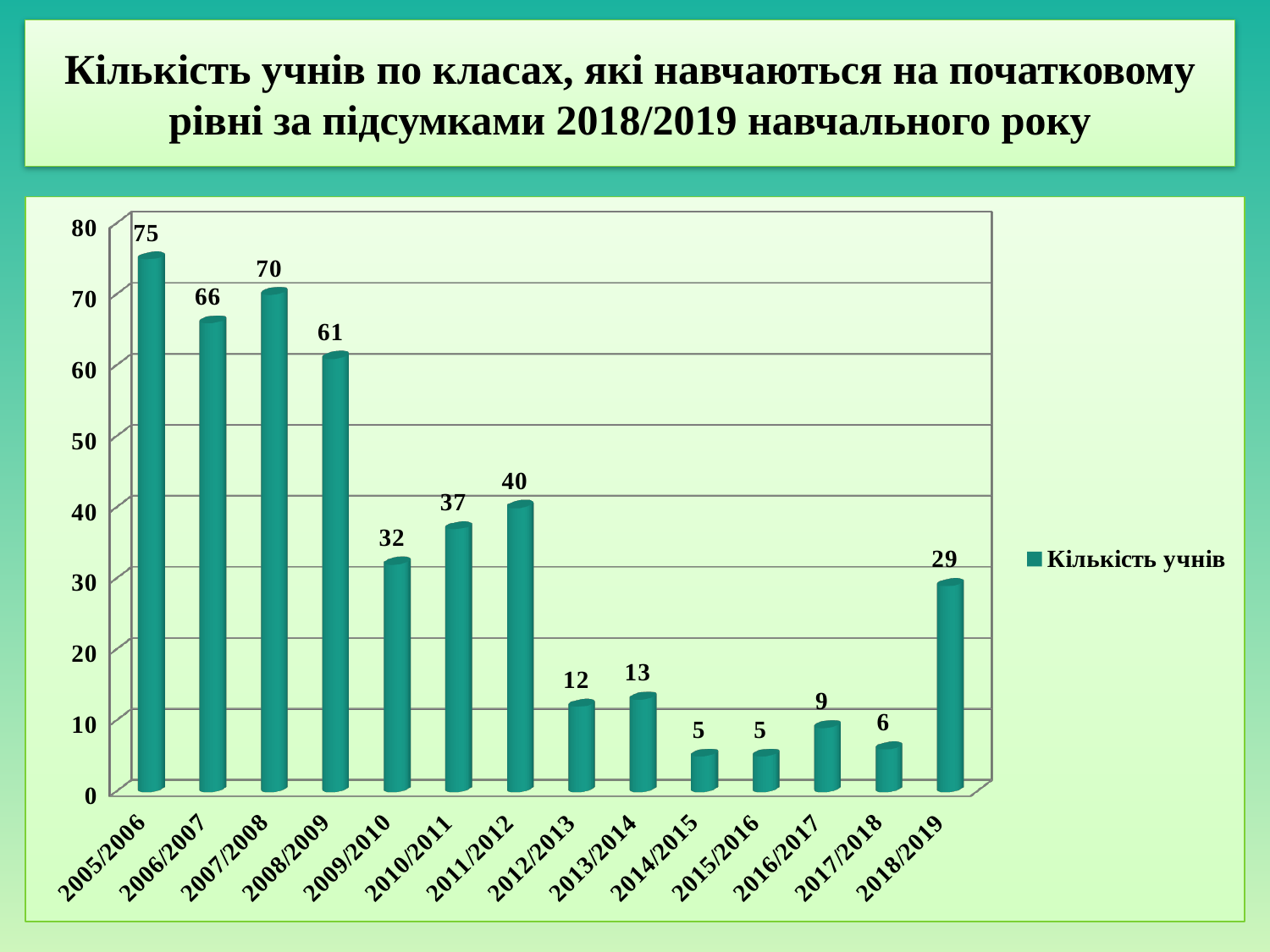
What is the value for 2011/2012? 40 What is the value for 2005/2006? 75 What is the value for 2018/2019? 29 How many series does the legend list? 1 Which is larger, the value for 2012/2013 or 2013/2014? 2013/2014 How many years are shown on the x axis? 14 Which year has the highest value? 2005/2006 What kind of chart is shown? bar chart What is the legend entry for the series? Кількість учнів What is the difference between the values for 2007/2008 and 2008/2009? 9 Is the value for 2009/2010 greater or less than 30? greater Do the values rise or fall from 2005/2006 to 2008/2009? fall